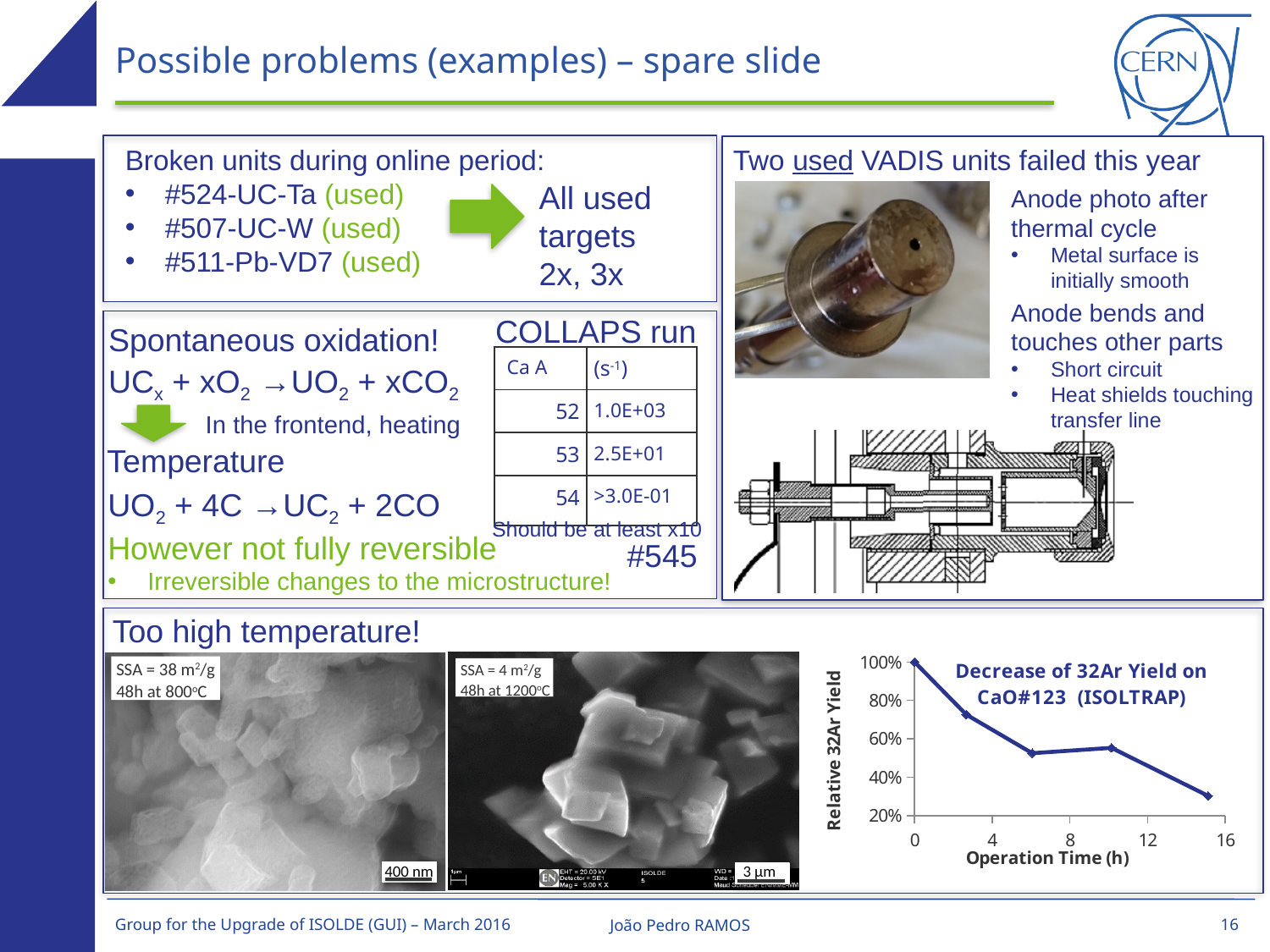
In the "Decrease of 32Ar Yield" chart, at which operation time is the relative yield highest? 0 h In the "Decrease of 32Ar Yield" chart, is the relative yield at about 6 h greater or less than 40%? greater In the "Decrease of 32Ar Yield" chart, is the relative yield at about 15 h greater or less than 40%? less What kind of chart is the "Decrease of 32Ar Yield on CaO#123 (ISOLTRAP)" chart? line chart What is the y-axis label of the "Decrease of 32Ar Yield" chart? Relative 32Ar Yield In the "Decrease of 32Ar Yield" chart, do the values rise or fall as operation time increases? fall In the "Decrease of 32Ar Yield" chart, what is the relative 32Ar yield at 0 h operation time? 100% What is the x-axis label of the "Decrease of 32Ar Yield" chart? Operation Time (h) In the "Decrease of 32Ar Yield" chart, which is larger: the relative yield at 0 h or at about 15 h? 0 h In the "Decrease of 32Ar Yield" chart, is the relative yield at about 2.5 h greater or less than 80%? less How many data points are plotted in the "Decrease of 32Ar Yield" chart? 5 In the "Decrease of 32Ar Yield" chart, which point has the lowest relative yield: the first or the last? the last